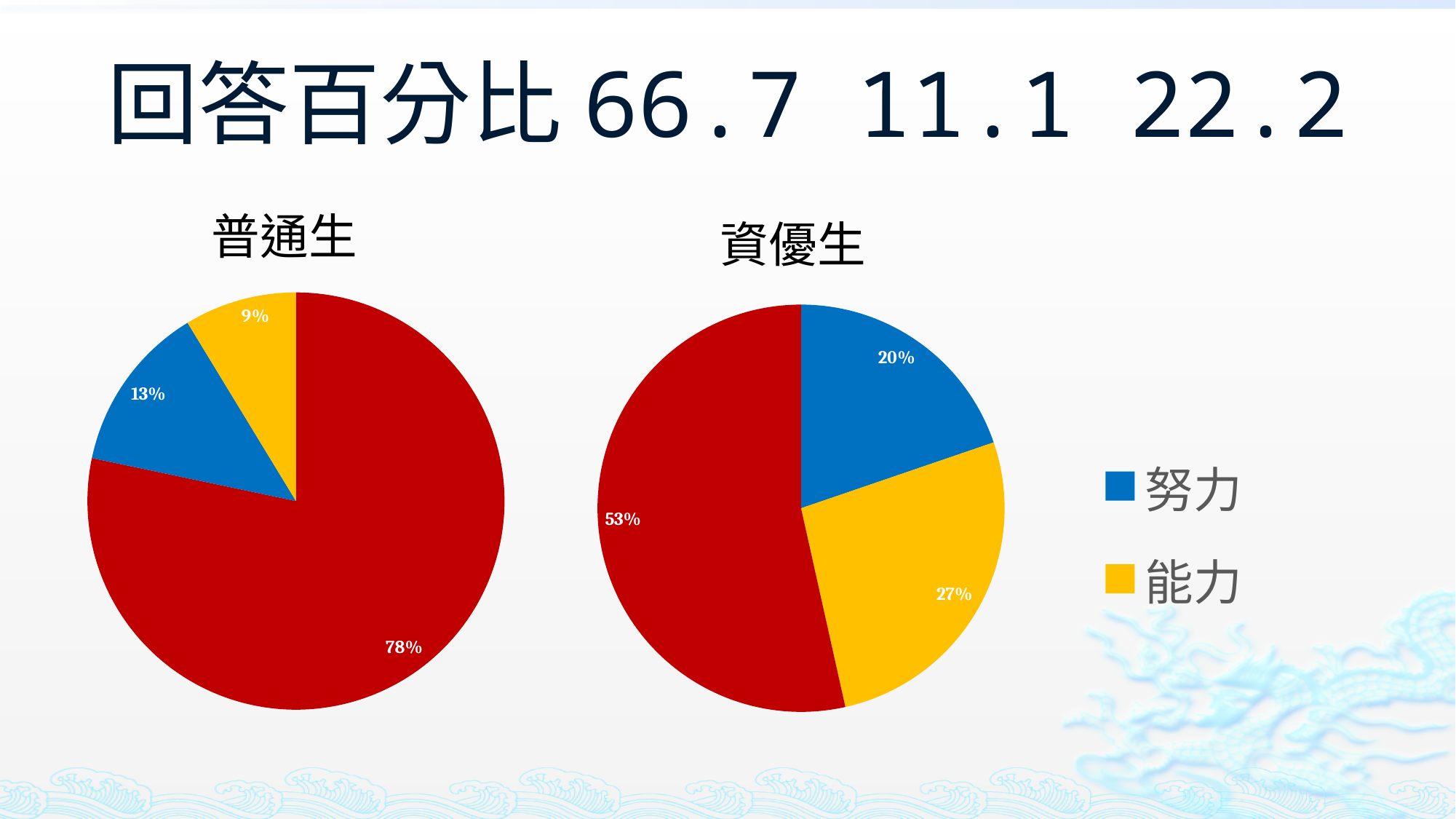
What kind of chart is the 資優生 chart? Pie chart In the 資優生 pie chart, which is larger, 努力 or 能力? 能力 In the 資優生 pie chart, what is the percentage of the largest slice? 53% How many entries does the legend on the slide list? 2 In the 普通生 pie chart, what is the percentage of the largest slice? 78% How many slices does the 普通生 pie chart have? 3 In the 資優生 pie chart, how many percentage points larger is 能力 than 努力? 7% In the 資優生 pie chart, what percentage is shown for 努力? 20% In the 資優生 pie chart, what percentage is shown for 能力? 27%